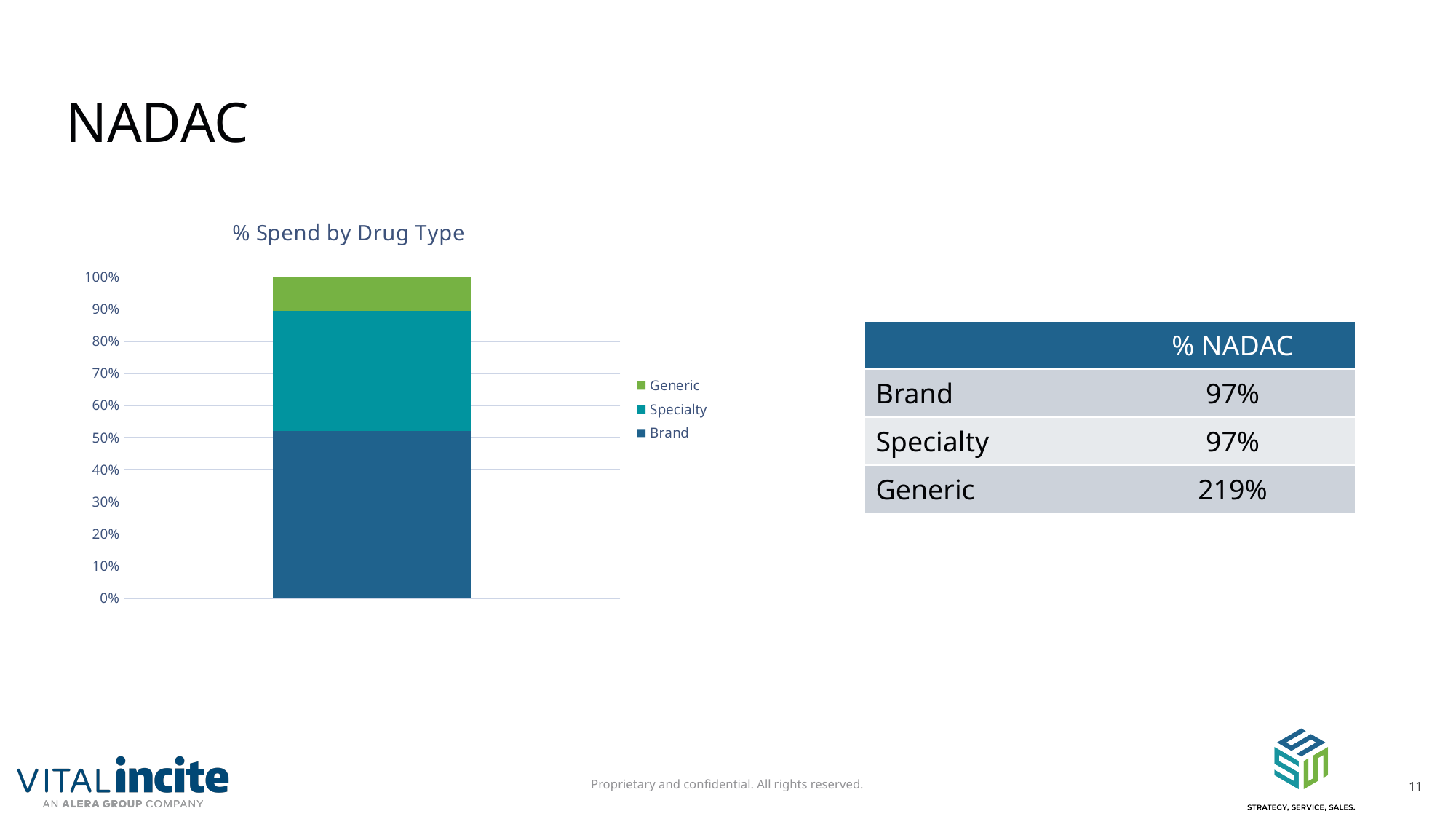
What kind of chart is shown on the slide? stacked bar chart How many series does the chart legend list? 3 Which series in the chart has the smallest segment of the bar? Generic Is the share of spend for Specialty greater or less than 30%? greater Which series in the chart has the largest segment of the bar? Brand Is the share of spend for Brand greater or less than 40%? greater Is the Brand segment of the bar larger or smaller than the Specialty segment? larger Is the Generic segment of the bar larger or smaller than the Specialty segment? smaller Is the share of spend for Generic greater or less than 20%? less What is the total height of the stacked bar in the chart? 100% What is the title of the chart? % Spend by Drug Type Which series is shown in green in the chart legend? Generic